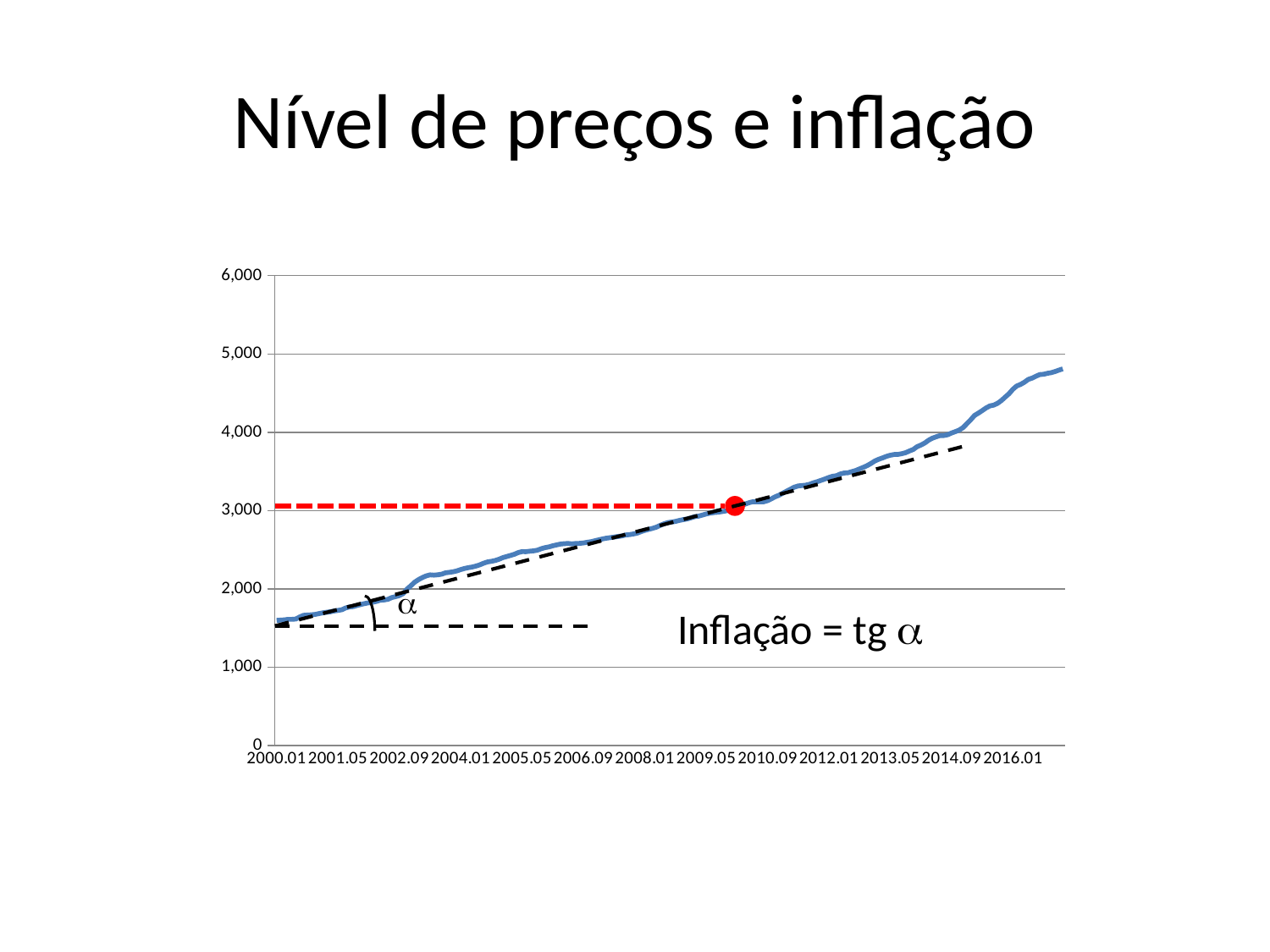
How many date labels are shown on the x axis? 13 Is the value at 2016.01 greater or less than 5,000? less Is the value at 2000.01 greater or less than 2,000? less What kind of chart is shown on the slide? line chart Do the plotted values rise or fall from 2000.01 to 2016.01? rise Is the value at 2013.05 greater or less than 4,000? less Which has the larger value, 2004.01 or 2014.09? 2014.09 What text annotation is written inside the chart area next to the angle α? Inflação = tg α What is the title of the slide containing the chart? Nível de preços e inflação